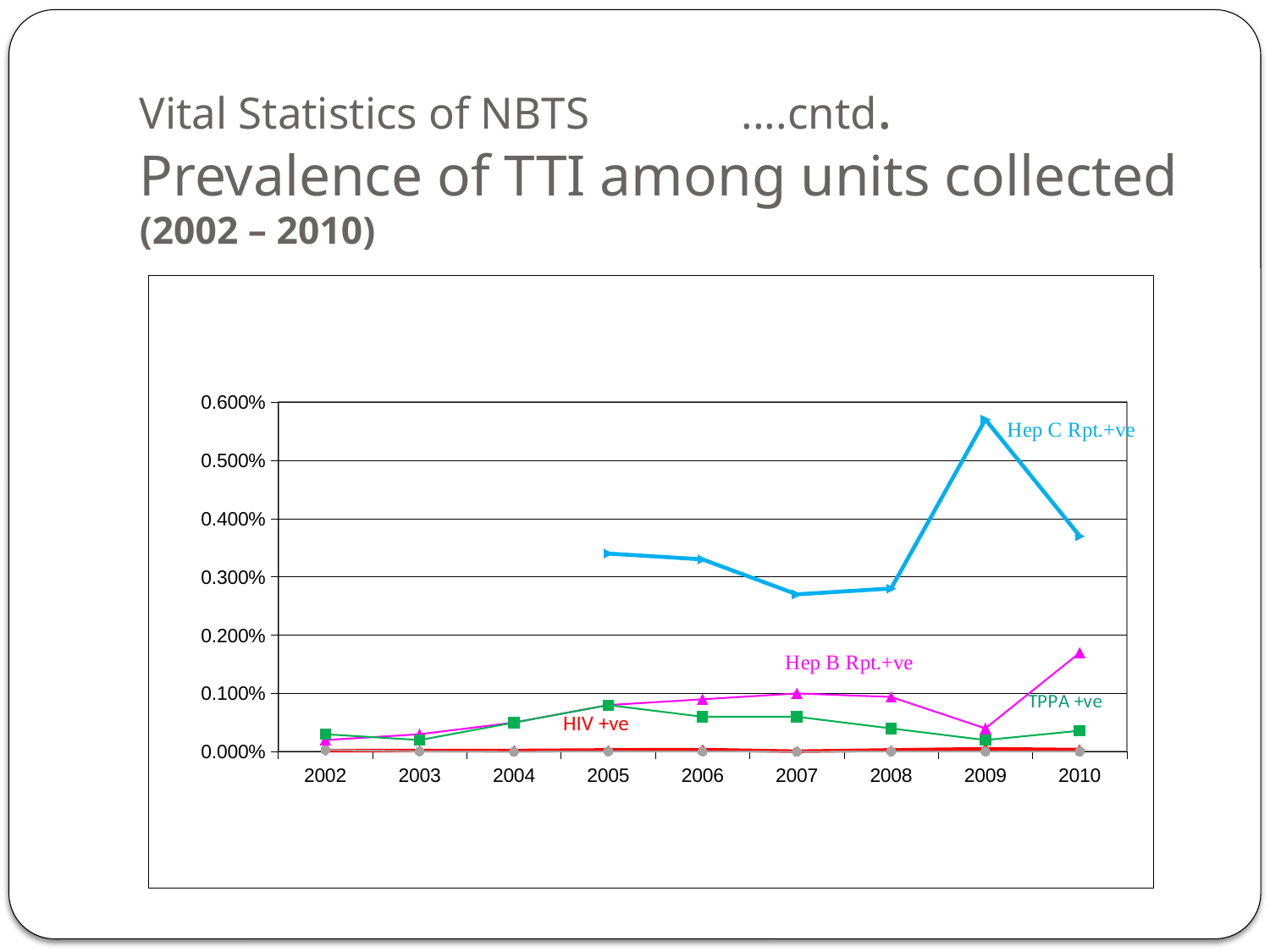
Is the value for Hep C Rpt.+ve in 2010 greater or less than 0.400%? less How many years are shown along the x axis of the chart? 9 In which year does the Hep C Rpt.+ve line reach its highest value? 2009 What kind of chart is shown on the slide? Line chart Is the value for Hep B Rpt.+ve in 2010 greater or less than 0.100%? greater How many data series are labelled on the chart? 4 Is the value for Hep C Rpt.+ve in 2007 greater or less than 0.300%? less In 2010, which is larger: Hep B Rpt.+ve or TPPA +ve? Hep B Rpt.+ve Does the Hep C Rpt.+ve line rise or fall from 2009 to 2010? Fall In which year does the Hep C Rpt.+ve series first appear on the chart? 2005